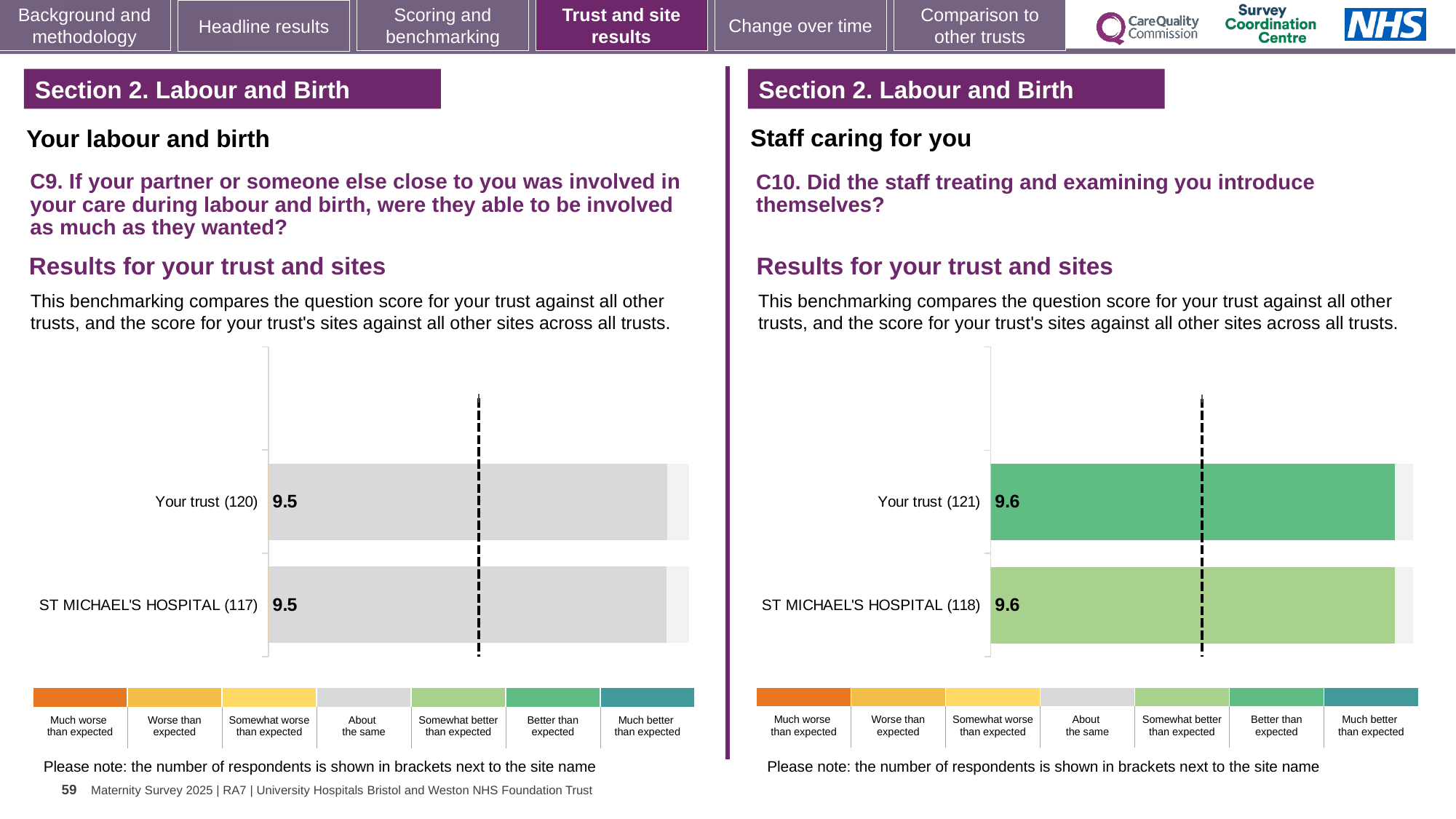
In the C10 chart on the right, which benchmark category does the colour of the ST MICHAEL'S HOSPITAL (118) bar correspond to in the legend? Somewhat better than expected In the C9 chart on the left, which benchmark category does the grey colour of the bars correspond to in the legend? About the same What kind of chart is used for the C9 results on the left? Bar chart How many bars are plotted in the C9 chart on the left? 2 In the C10 chart on the right, what is the score for Your trust (121)? 9.6 In the C9 chart on the left, what is the score for Your trust (120)? 9.5 In the C10 chart on the right, what is the score for ST MICHAEL'S HOSPITAL (118)? 9.6 How many respondents are shown in brackets for Your trust in the C10 chart on the right? 121 In the C9 chart on the left, what is the difference between the score for Your trust and the score for ST MICHAEL'S HOSPITAL? 0 In the C9 chart on the left, what is the score for ST MICHAEL'S HOSPITAL (117)? 9.5 How many bars are plotted in the C10 chart on the right? 2 In the C10 chart on the right, what is the difference between the score for Your trust and the score for ST MICHAEL'S HOSPITAL? 0